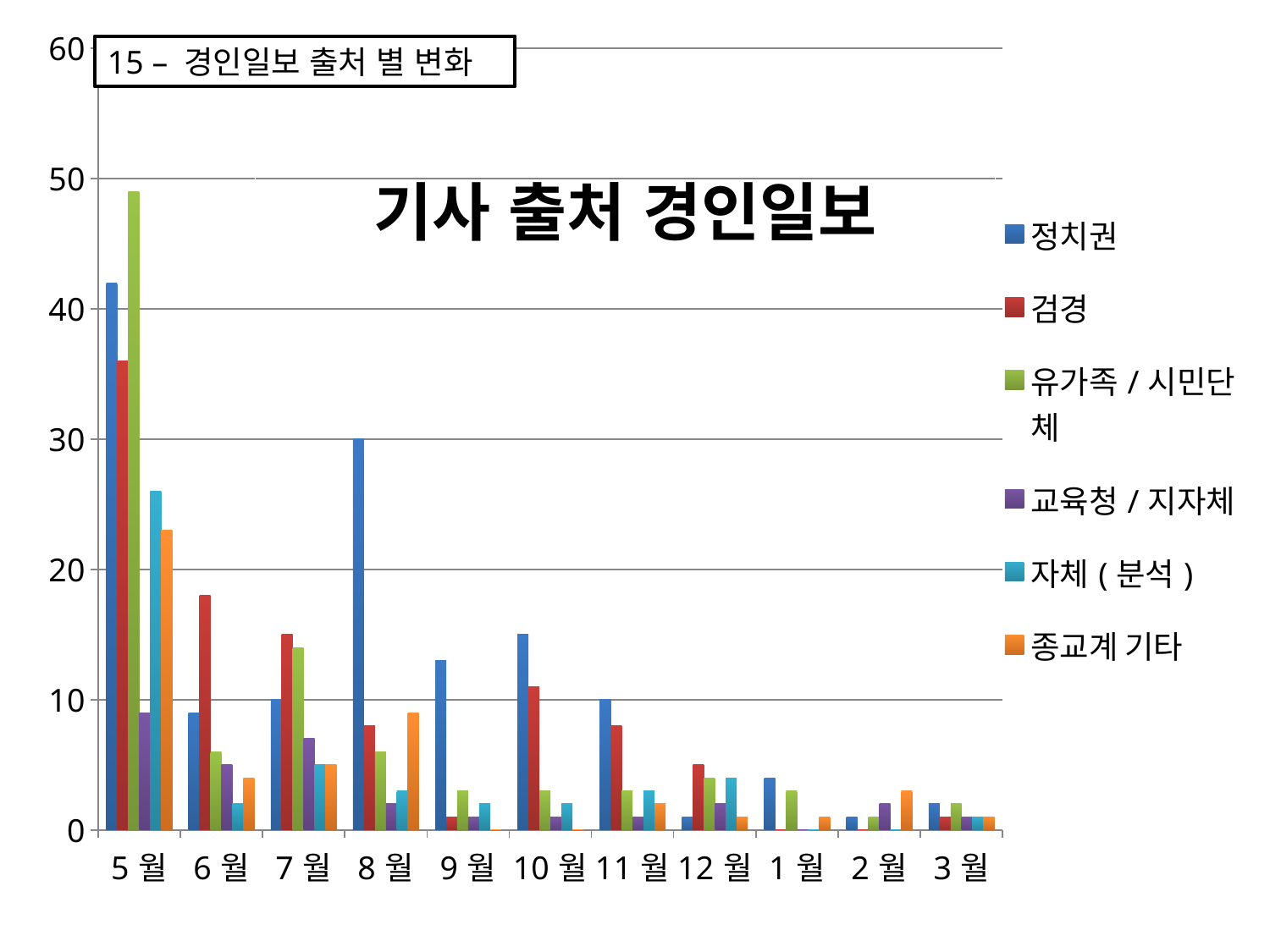
Does the 정치권 value generally rise or fall from 8 월 to 3 월? fall In which month is the 유가족 / 시민단체 value highest? 5 월 How many series does the legend list? 6 Is the value for 검경 in 6 월 greater or less than 20? less What is the large title printed inside the chart area? 기사 출처 경인일보 In which month is the 정치권 value highest? 5 월 What kind of chart is shown on the slide? bar chart What is the value for 정치권 in 8 월? 30 What is the value for 정치권 in 11 월? 10 Which is larger in 5 월: 정치권 or 검경? 정치권 How many month categories are shown on the x axis? 11 Is the value for 유가족 / 시민단체 in 5 월 greater or less than 40? greater